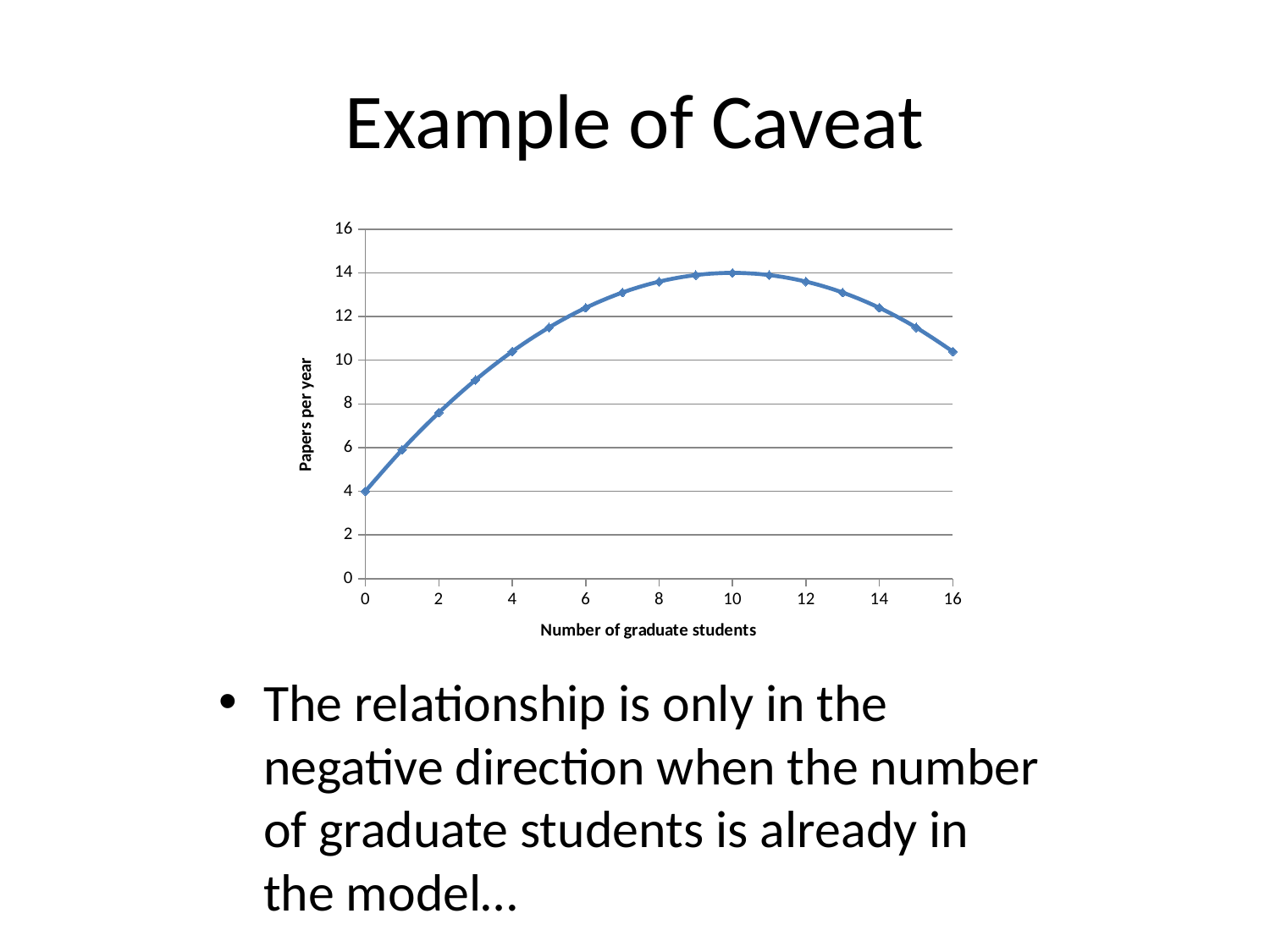
What is the label of the vertical axis? Papers per year What kind of chart is shown on the slide? line chart What is the value of papers per year when the number of graduate students is 10? 14 How many data points are plotted on the line? 17 Is the value of papers per year for 16 graduate students greater or less than 10? greater Which has more papers per year: 2 graduate students or 14 graduate students? 14 graduate students Is the value of papers per year for 2 graduate students greater or less than 8? less What is the label of the horizontal axis? Number of graduate students What is the difference in papers per year between 10 graduate students and 0 graduate students? 10 What is the value of papers per year when the number of graduate students is 0? 4 At which number of graduate students is papers per year lowest? 0 At which number of graduate students is papers per year highest? 10